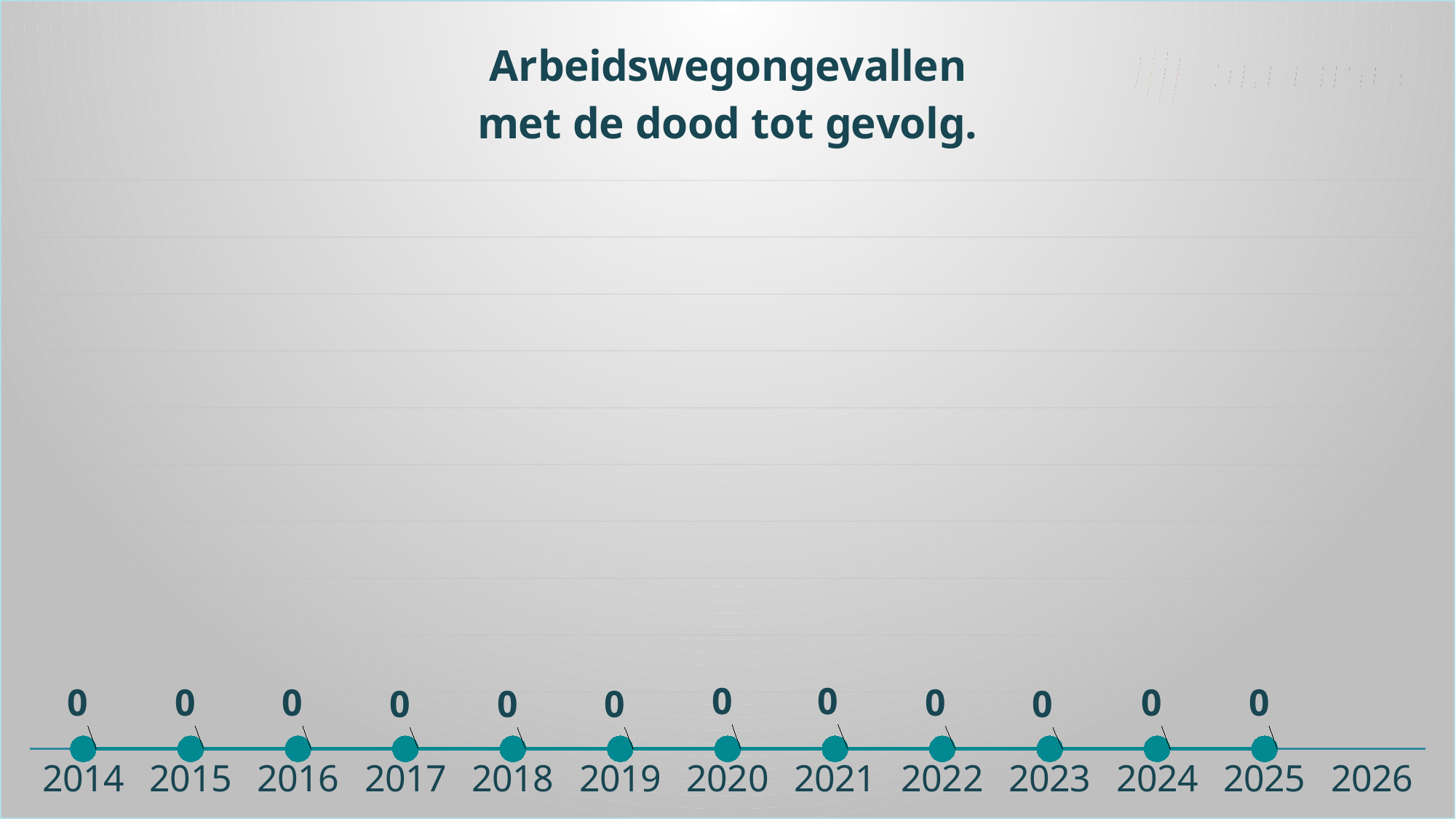
What is the value for 2020? 0 Which year on the x axis has no data point plotted? 2026 What is the value for 2016? 0 What is the title of the chart? Arbeidswegongevallen met de dood tot gevolg. How many data points are plotted on the chart? 12 What is the value for 2014? 0 What is the value for 2025? 0 Is the value for 2021 larger than, smaller than, or equal to the value for 2022? equal What is the value for 2018? 0 Do the values rise, fall, or stay the same from 2014 to 2025? stay the same What is the difference between the values for 2019 and 2023? 0 What kind of chart is shown on the slide? line chart